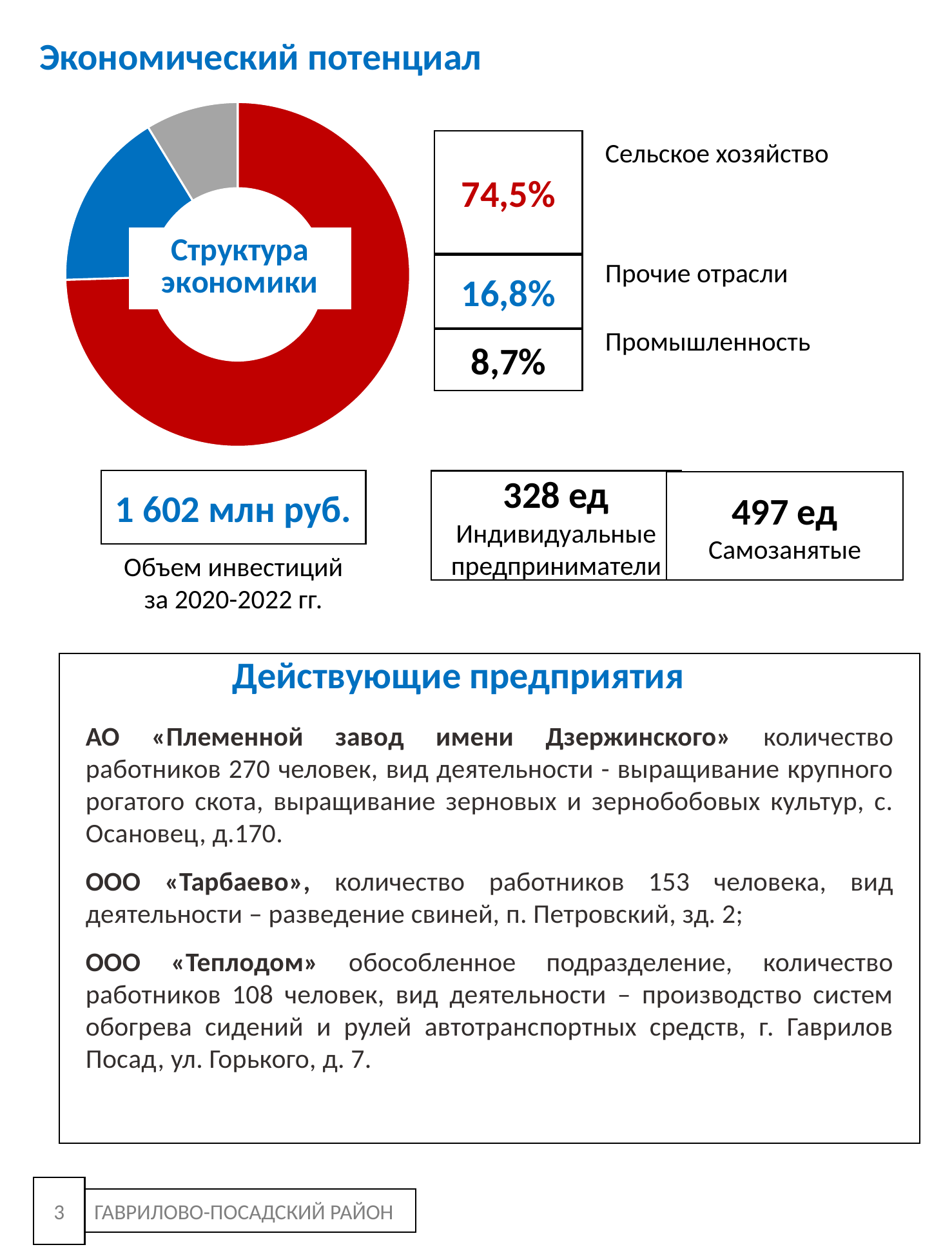
In the "Структура экономики" chart, what is the difference between "Прочие отрасли" and "Промышленность"? 8,1 In the "Структура экономики" chart, which is larger: "Прочие отрасли" or "Промышленность"? Прочие отрасли What share is shown for "Промышленность" in the "Структура экономики" chart? 8,7% In the "Структура экономики" chart, how many percentage points larger is "Сельское хозяйство" than "Прочие отрасли"? 57,7 What share of the economy does "Сельское хозяйство" account for in the "Структура экономики" chart? 74,5% What colour is the "Сельское хозяйство" segment in the "Структура экономики" chart? Red Which sector has the smallest share in the "Структура экономики" chart? Промышленность What kind of chart is the "Структура экономики" chart? Doughnut (pie) chart Is the share of "Сельское хозяйство" in the "Структура экономики" chart greater or less than 50%? greater Which sector has the largest share in the "Структура экономики" chart? Сельское хозяйство How many segments does the "Структура экономики" chart have? 3 What share is shown for "Прочие отрасли" in the "Структура экономики" chart? 16,8%